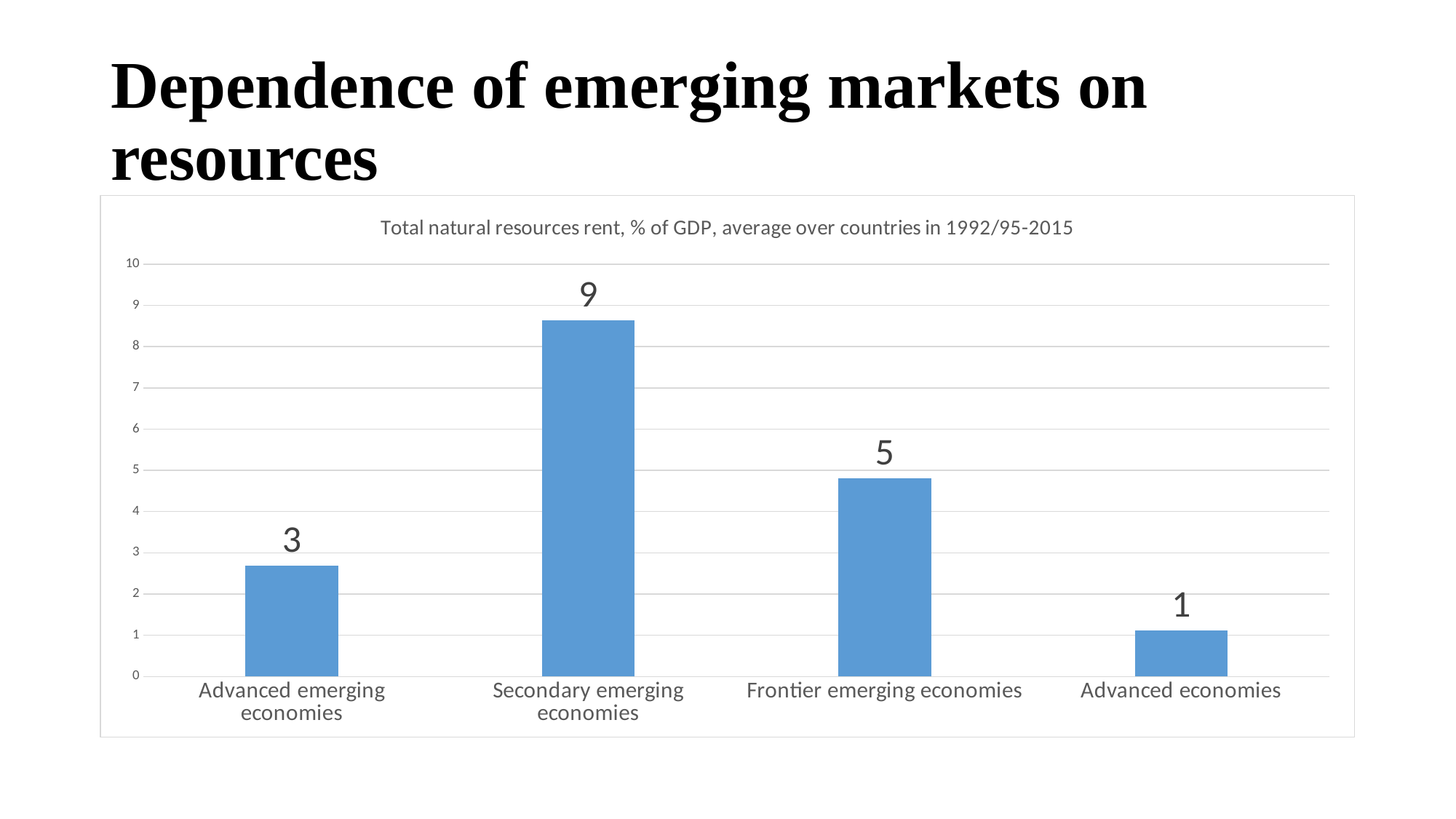
What kind of chart is shown on the slide? Bar chart Which category has the lowest value? Advanced economies What is the title of the chart? Total natural resources rent, % of GDP, average over countries in 1992/95-2015 Which is larger, the value for Frontier emerging economies or the value for Advanced emerging economies? Frontier emerging economies What is the difference between the labelled values for Secondary emerging economies and Advanced emerging economies? 6 Is the value for Secondary emerging economies greater or less than 8? greater How many categories are shown on the x axis? 4 What is the value shown for Advanced emerging economies? 3 What is the value shown for Frontier emerging economies? 5 What is the value shown for Secondary emerging economies? 9 What is the value shown for Advanced economies? 1 Which category has the highest value? Secondary emerging economies